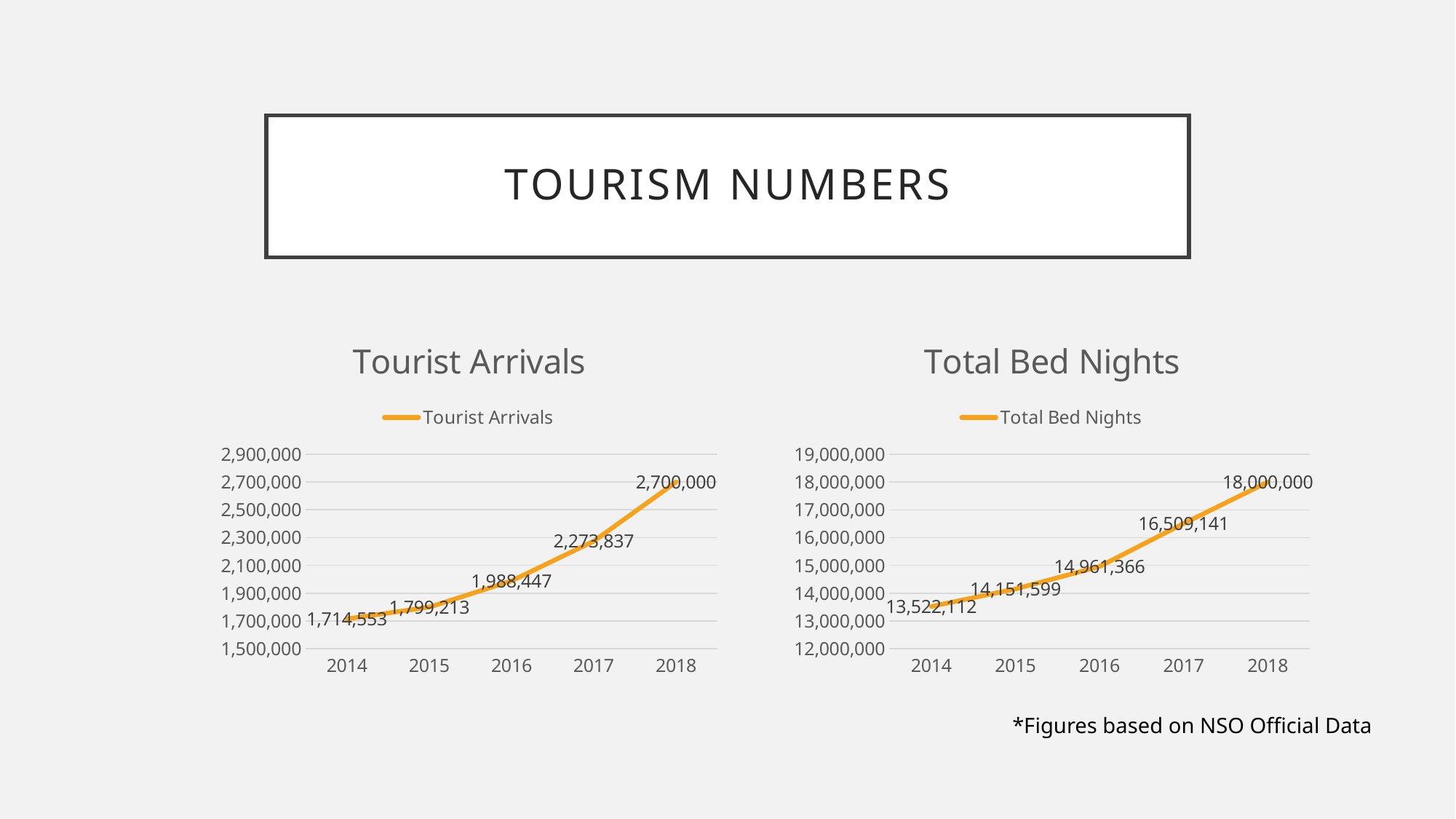
In the Tourist Arrivals chart, which year has the lowest value? 2014 What kind of chart is the Total Bed Nights chart? Line chart In the Total Bed Nights chart, which year has the highest value? 2018 How many series does the legend of the Total Bed Nights chart list? 1 In the Tourist Arrivals chart, do the values rise or fall from 2014 to 2018? Rise In the Tourist Arrivals chart, what is the difference between the 2018 and 2017 values? 426,163 In the Total Bed Nights chart, what is the value for 2017? 16,509,141 In the Total Bed Nights chart, is the value for 2016 larger than the value for 2015? Yes In the Tourist Arrivals chart, what is the value for 2014? 1,714,553 In the Total Bed Nights chart, what is the difference between the 2015 and 2014 values? 629,487 In the Tourist Arrivals chart, what is the value for 2016? 1,988,447 How many years are plotted in the Tourist Arrivals chart? 5